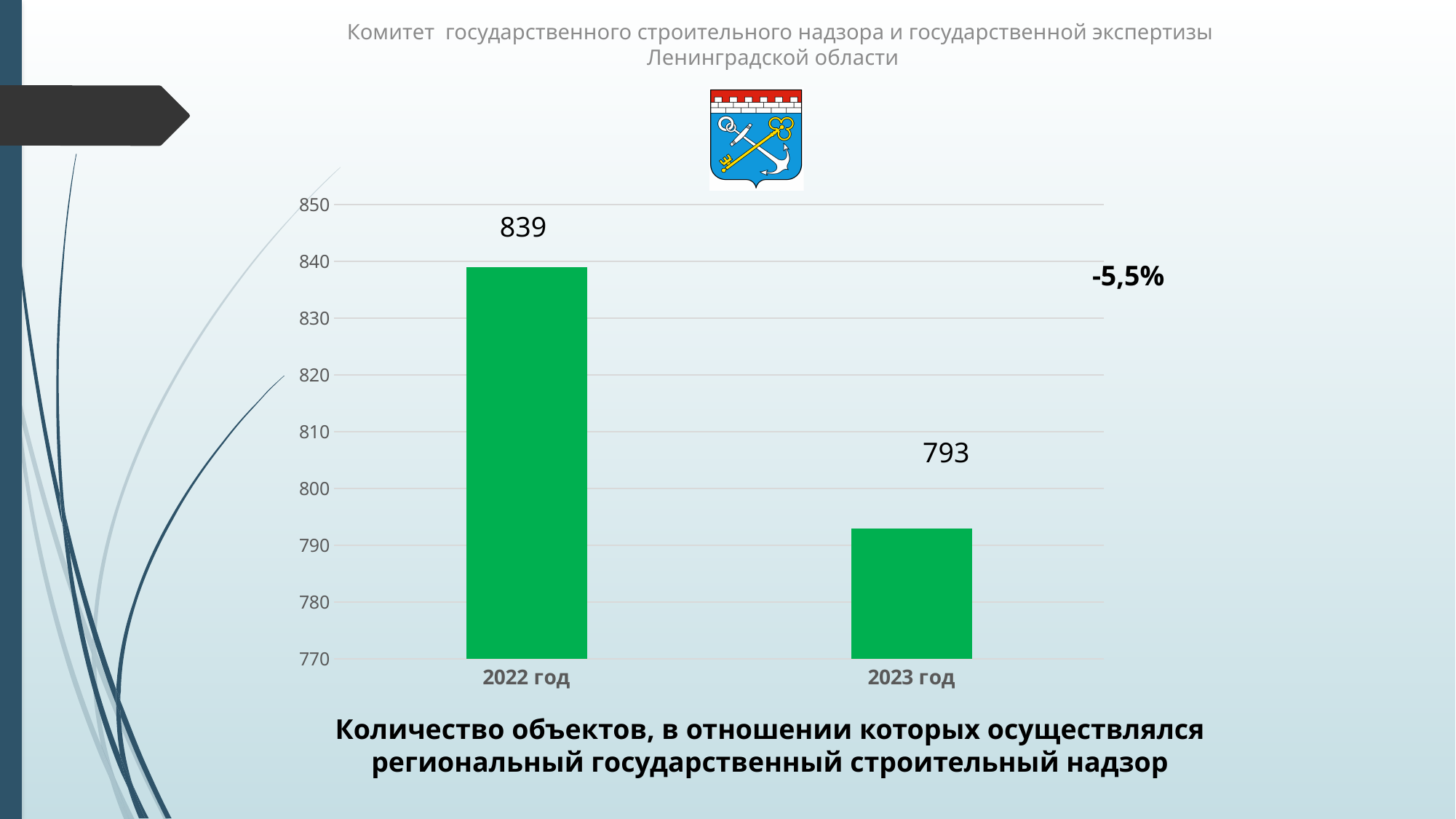
Which year has the higher value? 2022 год Is the value for 2022 год greater or less than 830? greater Which year has the lower value? 2023 год Do the values rise or fall from 2022 год to 2023 год? fall What kind of chart is shown on the slide? bar chart What is the difference between the values for 2022 год and 2023 год? 46 How many categories are shown on the x axis? 2 Is the value for 2022 год larger or smaller than the value for 2023 год? larger What is the value for 2022 год? 839 What is the value for 2023 год? 793 Is the value for 2023 год greater or less than 800? less What percentage change is printed next to the chart? -5,5%